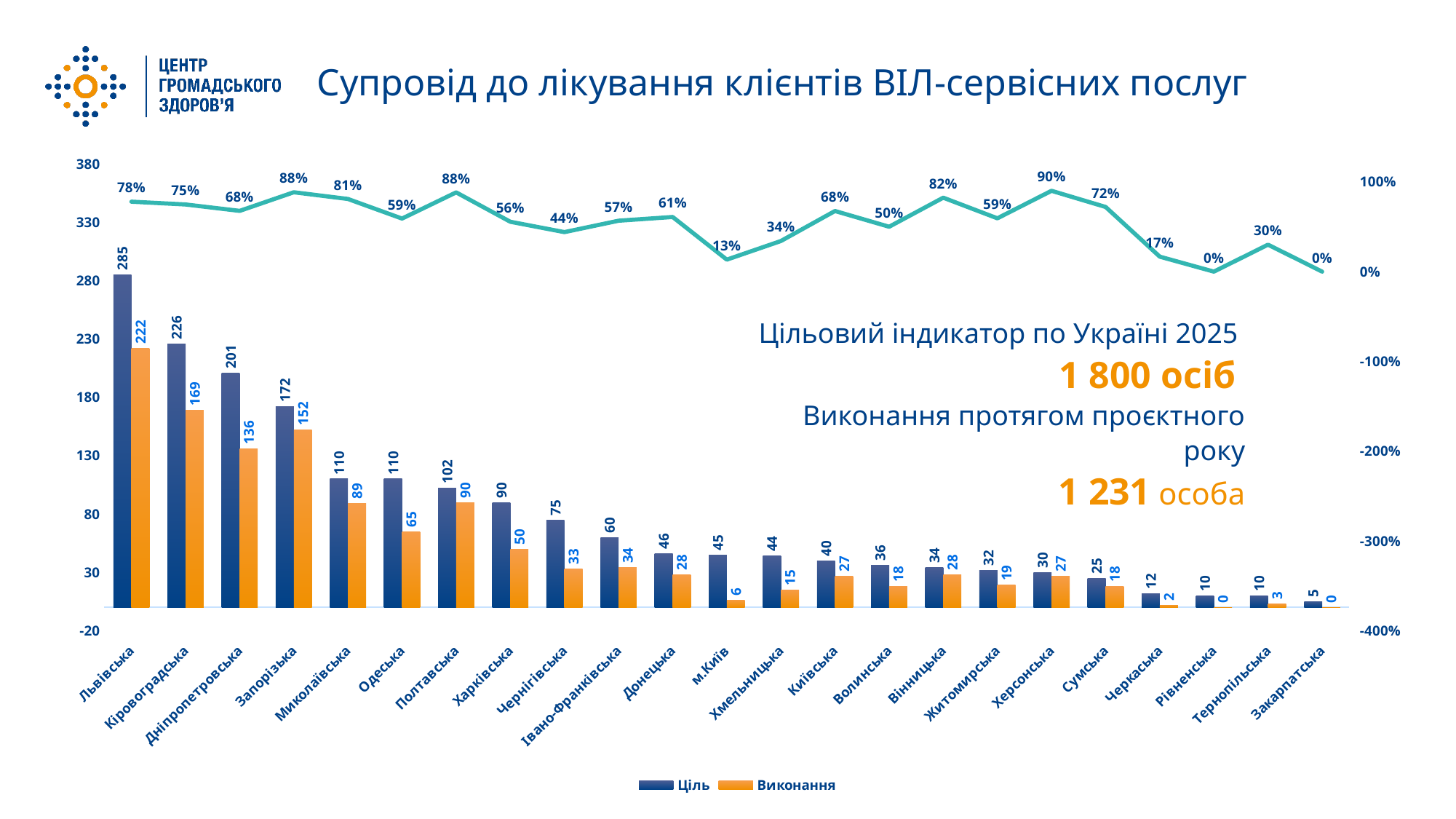
How many series does the legend list? 2 What is the Ціль value for Запорізька? 172 Which region has the lowest Ціль value? Закарпатська What is the difference between the Ціль and Виконання values for Дніпропетровська? 65 Which region has the highest Ціль value? Львівська Do the Ціль values rise or fall from left to right along the x axis? Fall Which is larger: the Виконання value for Харківська or the Виконання value for Полтавська? Полтавська What colour are the Виконання bars? Orange What percentage is shown on the line for Херсонська? 90% What kind of chart is used for the Ціль and Виконання series? Bar chart How many regions are shown on the x axis? 23 What is the Виконання value for Одеська? 65